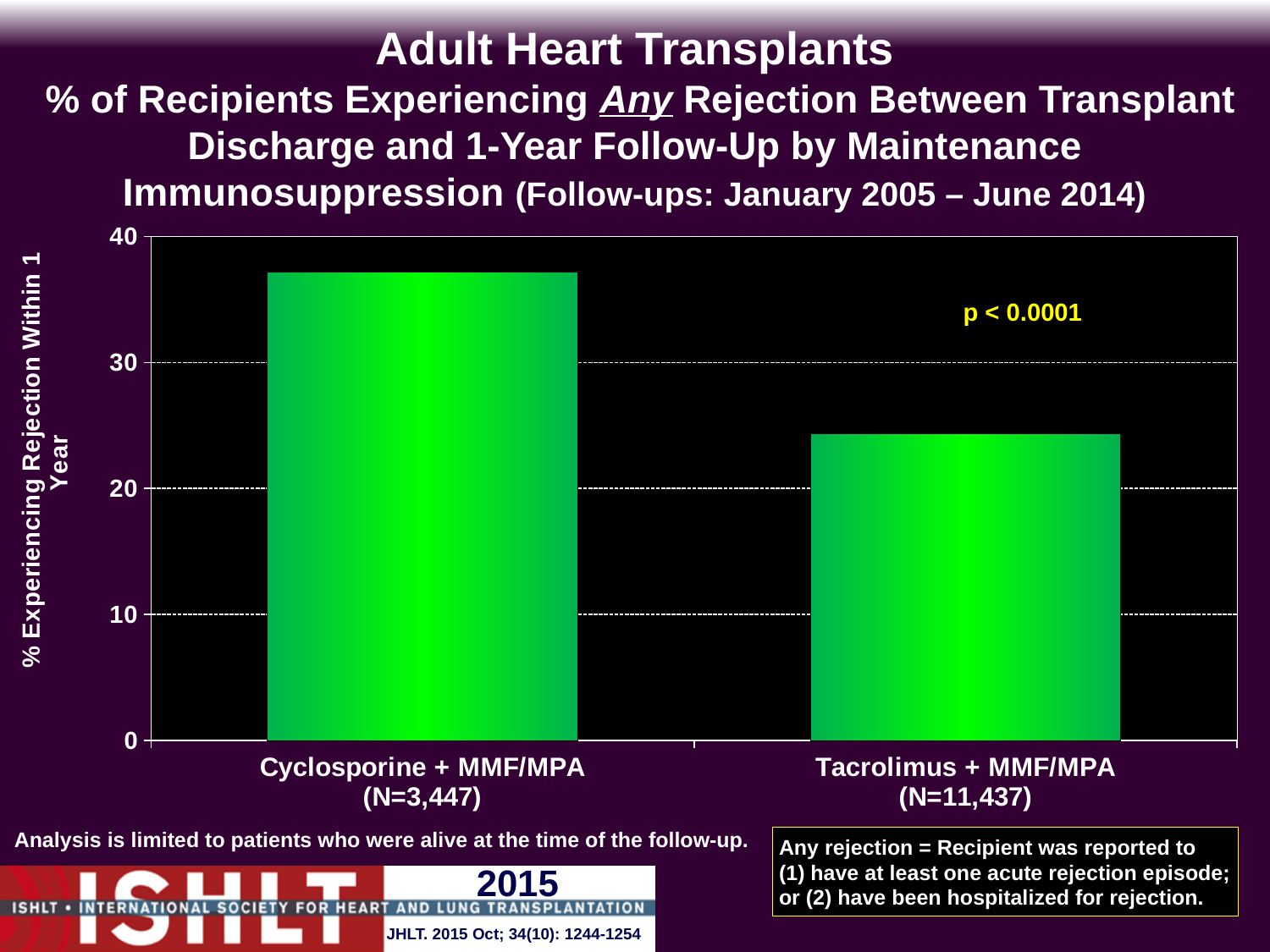
Is the value for Tacrolimus + MMF/MPA greater or less than 20? greater How many categories (bars) are plotted in the chart? 2 Is the value for Tacrolimus + MMF/MPA greater or less than 30? less Is the value for Cyclosporine + MMF/MPA greater or less than 30? greater Which is larger: the value for Cyclosporine + MMF/MPA or the value for Tacrolimus + MMF/MPA? Cyclosporine + MMF/MPA What p-value is printed on the chart? p < 0.0001 Which category has the highest % experiencing rejection within 1 year? Cyclosporine + MMF/MPA What is the label of the y axis? % Experiencing Rejection Within 1 Year What kind of chart is shown on the slide? bar chart Which category has the lowest % experiencing rejection within 1 year? Tacrolimus + MMF/MPA